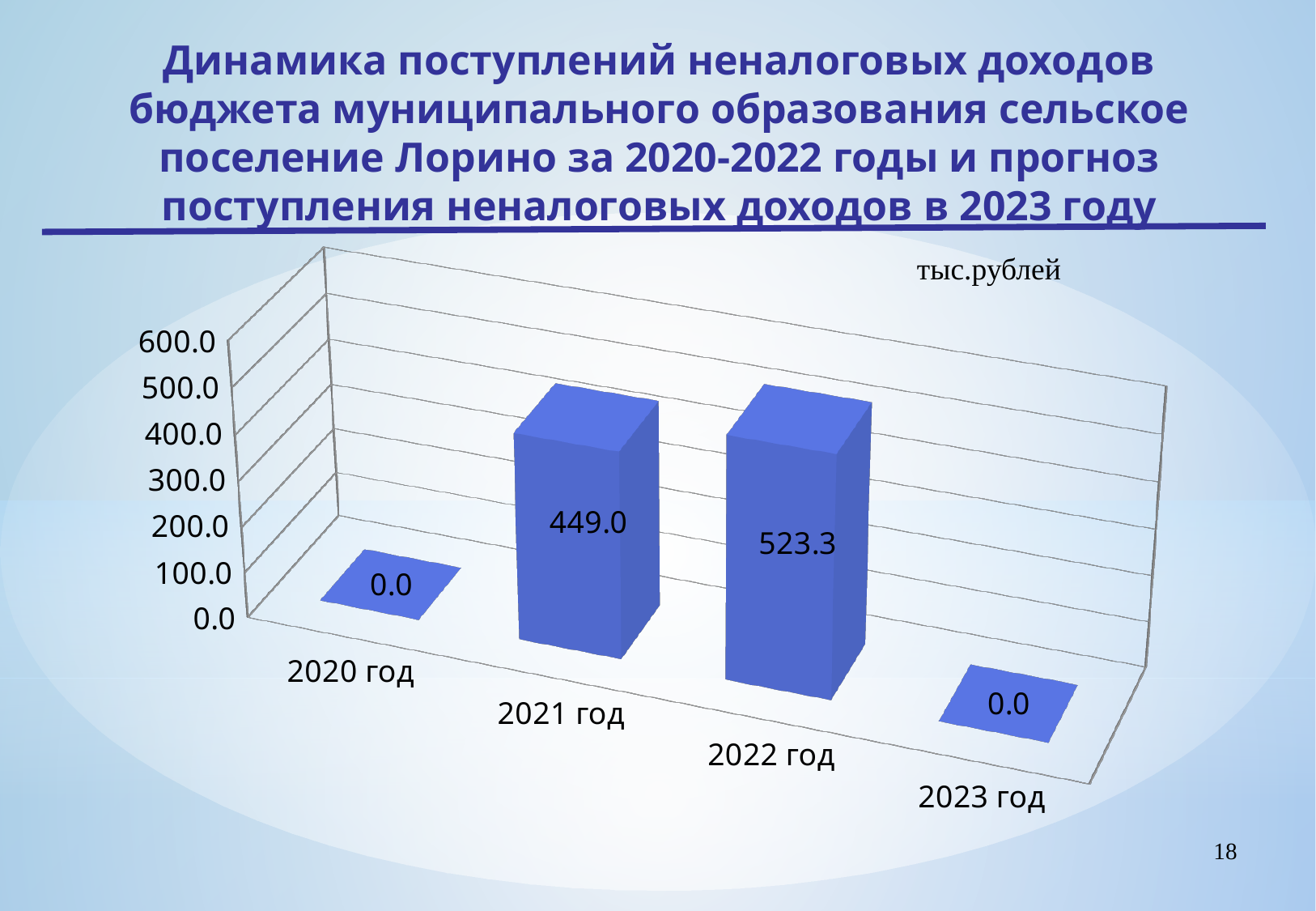
Is the value for 2021 год greater or less than 400.0? greater What is the value for 2021 год? 449.0 What is the value for 2022 год? 523.3 Which is larger, the value for 2021 год or the value for 2022 год? 2022 год What unit of measurement is indicated on the chart? тыс.рублей What is the highest tick value shown on the vertical axis? 600.0 What kind of chart is shown on the slide? bar chart What is the value for 2020 год? 0.0 What is the value for 2023 год? 0.0 What is the difference between the values for 2022 год and 2021 год? 74.3 How many years are shown on the x axis? 4 Which year has the highest value? 2022 год